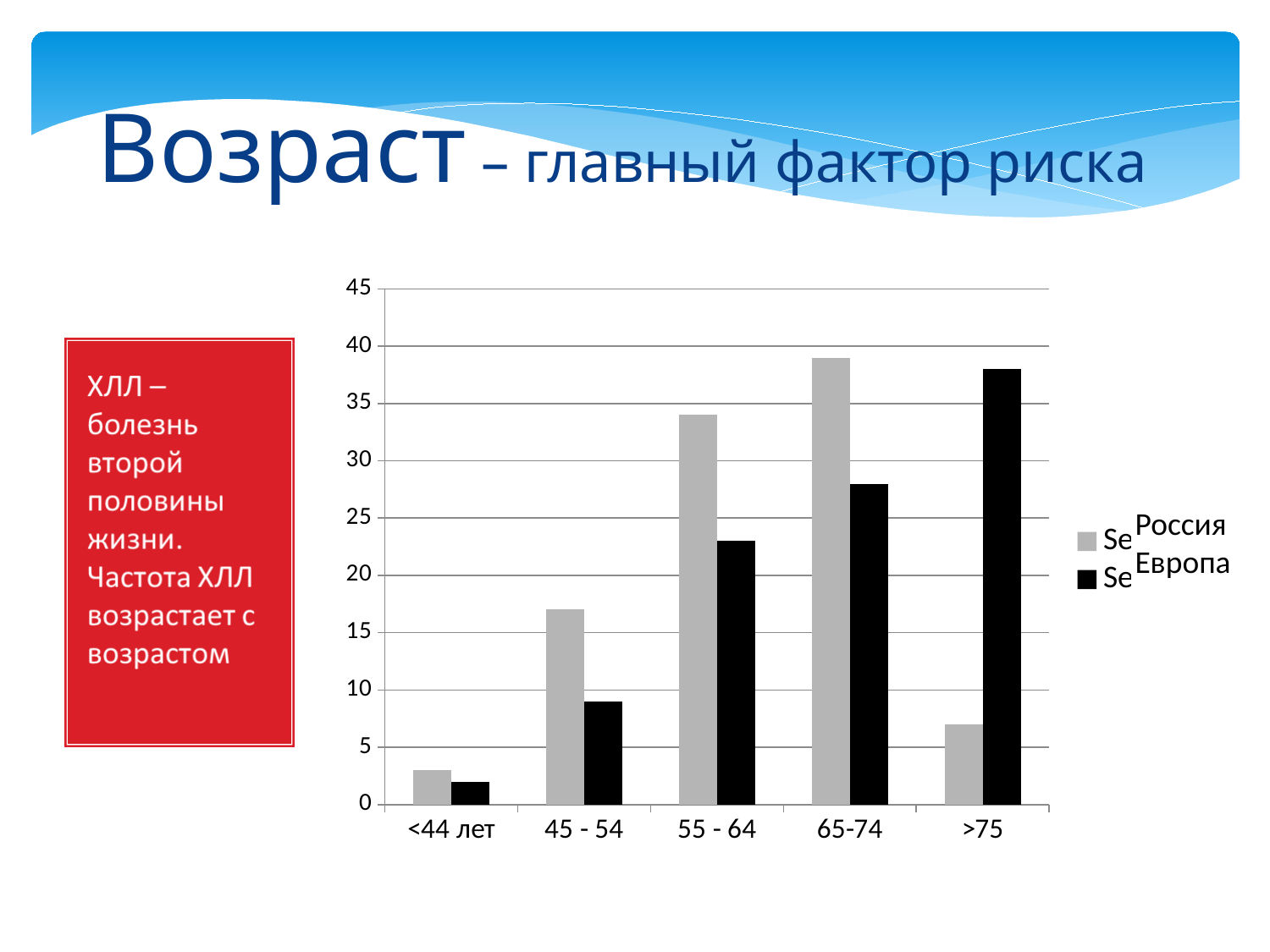
In the >75 category, which series has the larger value, Россия or Европа? Европа How many series does the chart's legend list? 2 Is the Европа value for 45 - 54 greater or less than 10? less For which age category is the Россия value highest? 65-74 In the 65-74 category, which series has the larger value, Россия or Европа? Россия What colour are the bars for the Европа series? black For which age category is the Россия value lowest? <44 лет How many age categories are shown on the x axis of the chart? 5 Is the Россия value for 55 - 64 greater or less than 30? greater For which age category is the Европа value highest? >75 For which age category is the Европа value lowest? <44 лет What kind of chart is shown on the slide? bar chart